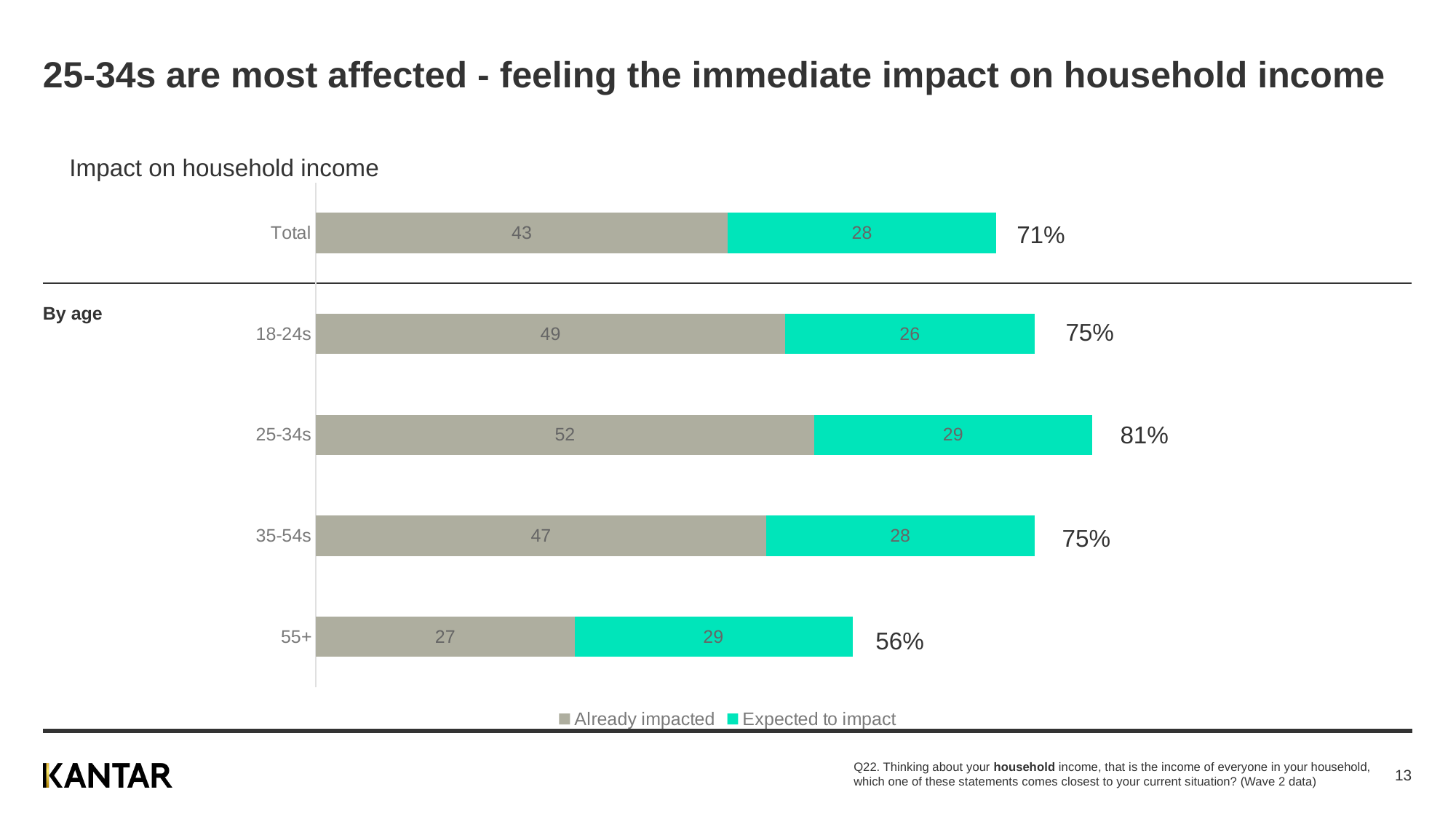
What is the combined total shown for the 25-34s bar? 81% What is the 'Already impacted' value for Total? 43 What is the combined total shown for the 55+ bar? 56% How many bars (categories) are shown in the chart? 5 What is the difference between the 'Already impacted' values for 18-24s and 55+? 22 Which age group has the highest 'Already impacted' value? 25-34s How many series does the legend list? 2 What is the 'Already impacted' value for the 25-34s age group? 52 Which age group has the lowest 'Already impacted' value? 55+ What is the 'Expected to impact' value for the 55+ age group? 29 What type of chart is shown on the slide? Stacked bar chart Which is larger: the 'Already impacted' value for 35-54s or for 18-24s? 18-24s